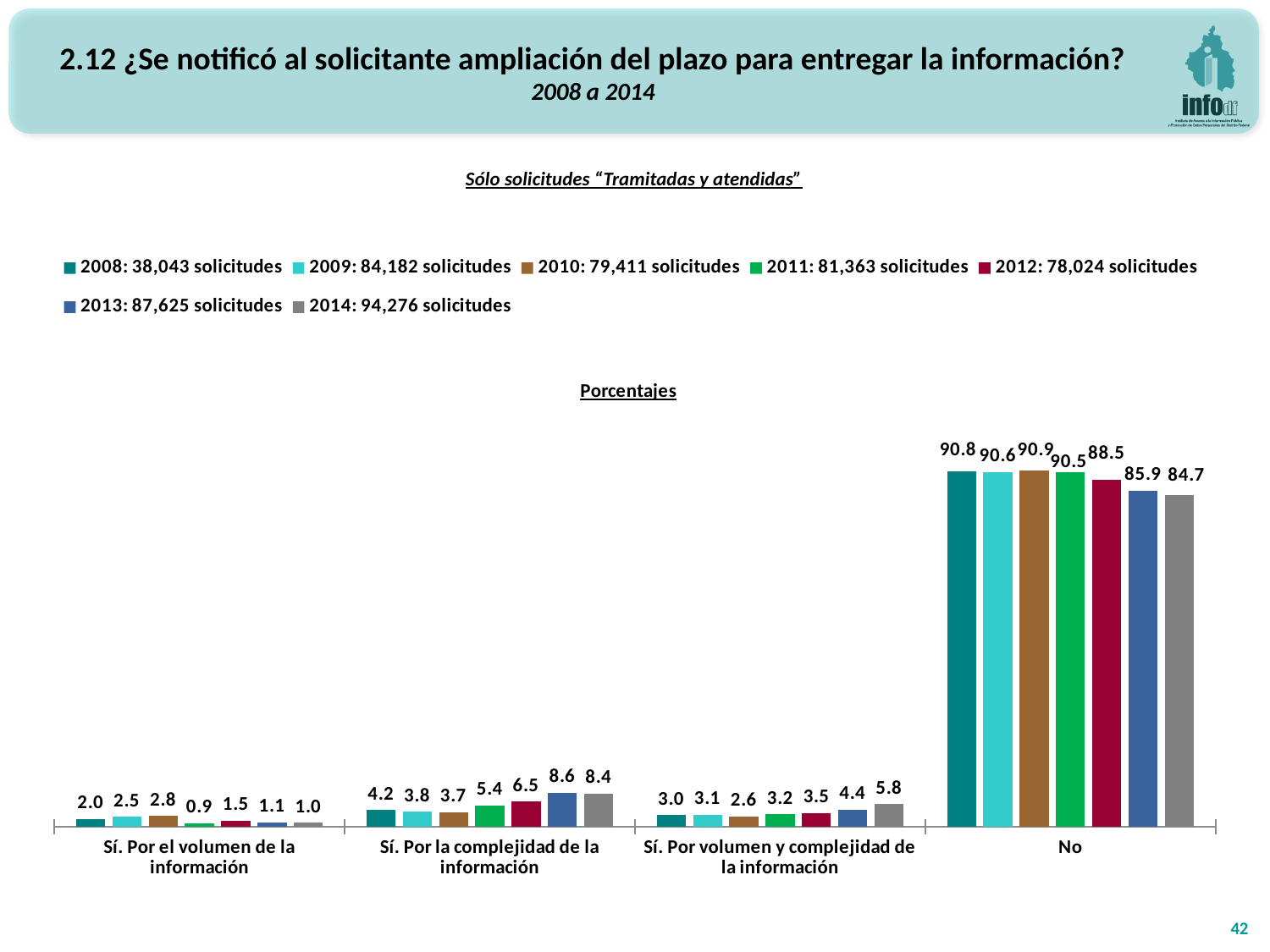
Which year has the highest value in the "No" category? 2010 What is the difference between the 2008 and 2014 values in the "No" category? 6.1 What is the value for 2010 in the "Sí. Por volumen y complejidad de la información" category? 2.6 Which year has the lowest value in the "Sí. Por el volumen de la información" category? 2011 What is the value for 2014 in the "No" category? 84.7 What kind of chart is shown on the slide? Bar chart How many categories are shown on the x axis? 4 What is the value for 2013 in the "Sí. Por la complejidad de la información" category? 8.6 How many series does the legend list? 7 What is the value for 2011 in the "Sí. Por el volumen de la información" category? 0.9 According to the legend, how many solicitudes were there in 2014? 94,276 Which is larger in the "Sí. Por la complejidad de la información" category: the value for 2012 or the value for 2013? 2013